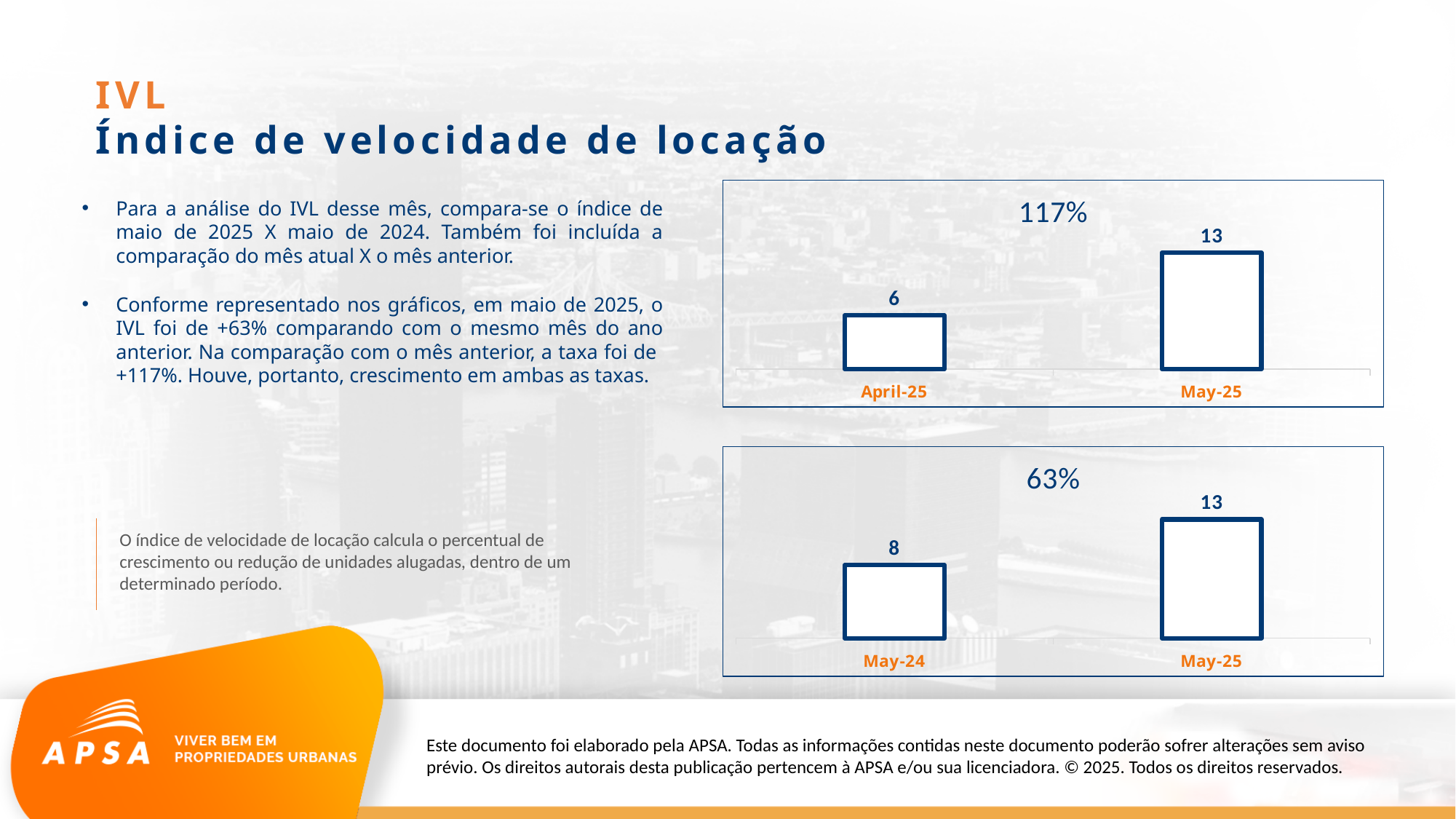
How many categories does the top chart show? 2 In the top chart, what is the value for April-25? 6 In the top chart, what is the difference between the values for May-25 and April-25? 7 In the bottom chart, what is the value for May-24? 8 In the bottom chart, which category has the lowest value? May-24 In the bottom chart, what is the difference between the values for May-25 and May-24? 5 In the top chart, which category has the highest value? May-25 What percentage is printed above the bars in the top chart? 117% In the bottom chart, which is larger, the value for May-24 or the value for May-25? May-25 In the top chart, what is the value for May-25? 13 In the bottom chart, what is the value for May-25? 13 What kind of chart is the bottom chart? Bar chart